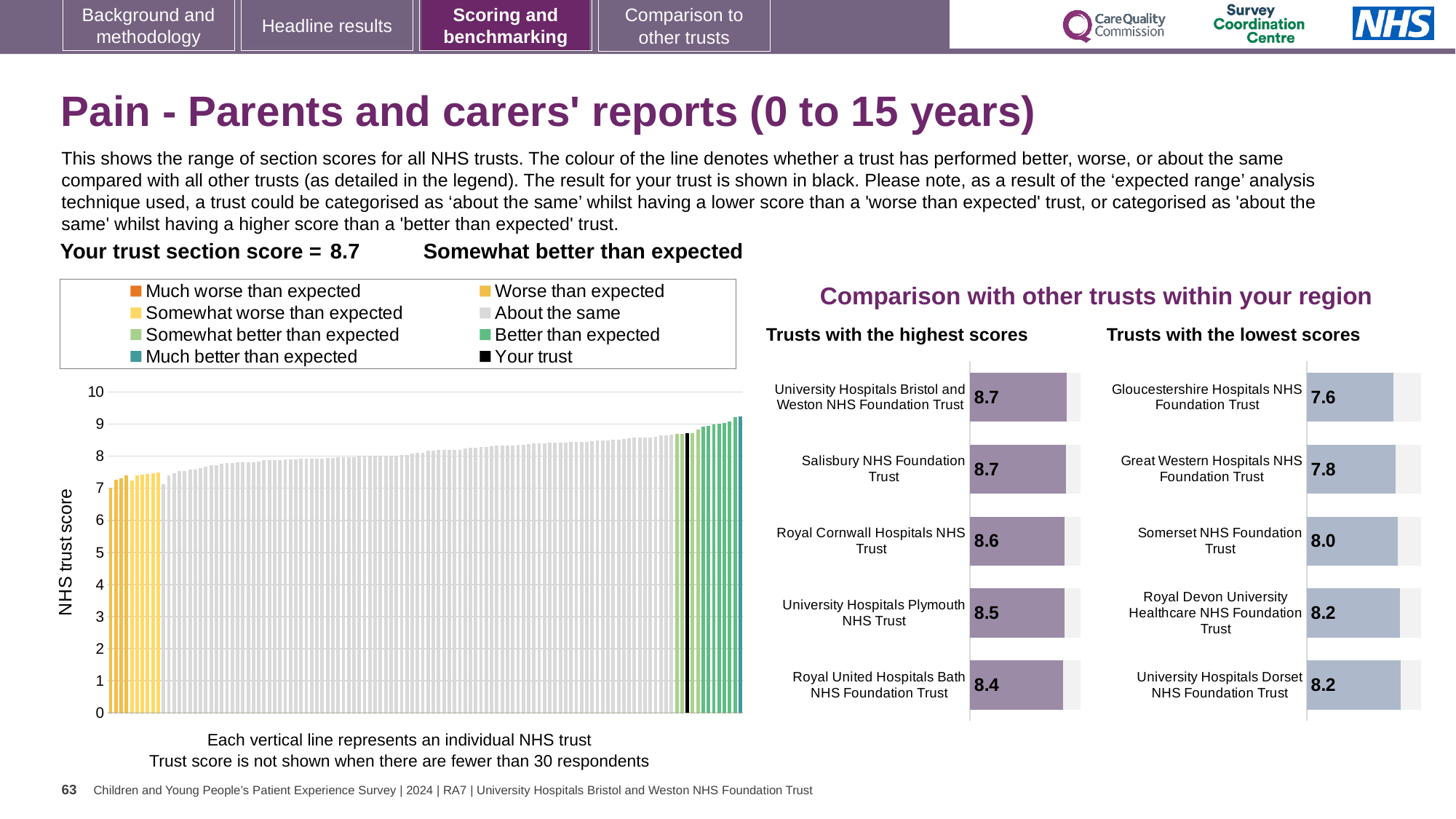
In the 'Trusts with the highest scores' chart, which trust has the lowest score? Royal United Hospitals Bath NHS Foundation Trust In the 'Trusts with the highest scores' chart, what is the score for Royal Cornwall Hospitals NHS Trust? 8.6 What type of chart is the large chart on the left showing all NHS trusts? bar chart In the 'Trusts with the highest scores' chart, how many trusts are shown? 5 In the large chart on the left, is the value for the black 'Your trust' bar greater or less than 8? greater In the 'Trusts with the lowest scores' chart, what is the difference between the scores of Somerset NHS Foundation Trust and Gloucestershire Hospitals NHS Foundation Trust? 0.4 In the large chart on the left, what is the label on the vertical axis? NHS trust score How many entries does the legend above the large chart on the left list? 8 In the large chart on the left, do the bar heights rise or fall from left to right? rise In the 'Trusts with the lowest scores' chart, which trust has the lowest score? Gloucestershire Hospitals NHS Foundation Trust In the 'Trusts with the lowest scores' chart, which has the higher score: Great Western Hospitals NHS Foundation Trust or Somerset NHS Foundation Trust? Somerset NHS Foundation Trust In the 'Trusts with the highest scores' chart, what is the difference between the scores of Royal Cornwall Hospitals NHS Trust and Royal United Hospitals Bath NHS Foundation Trust? 0.2